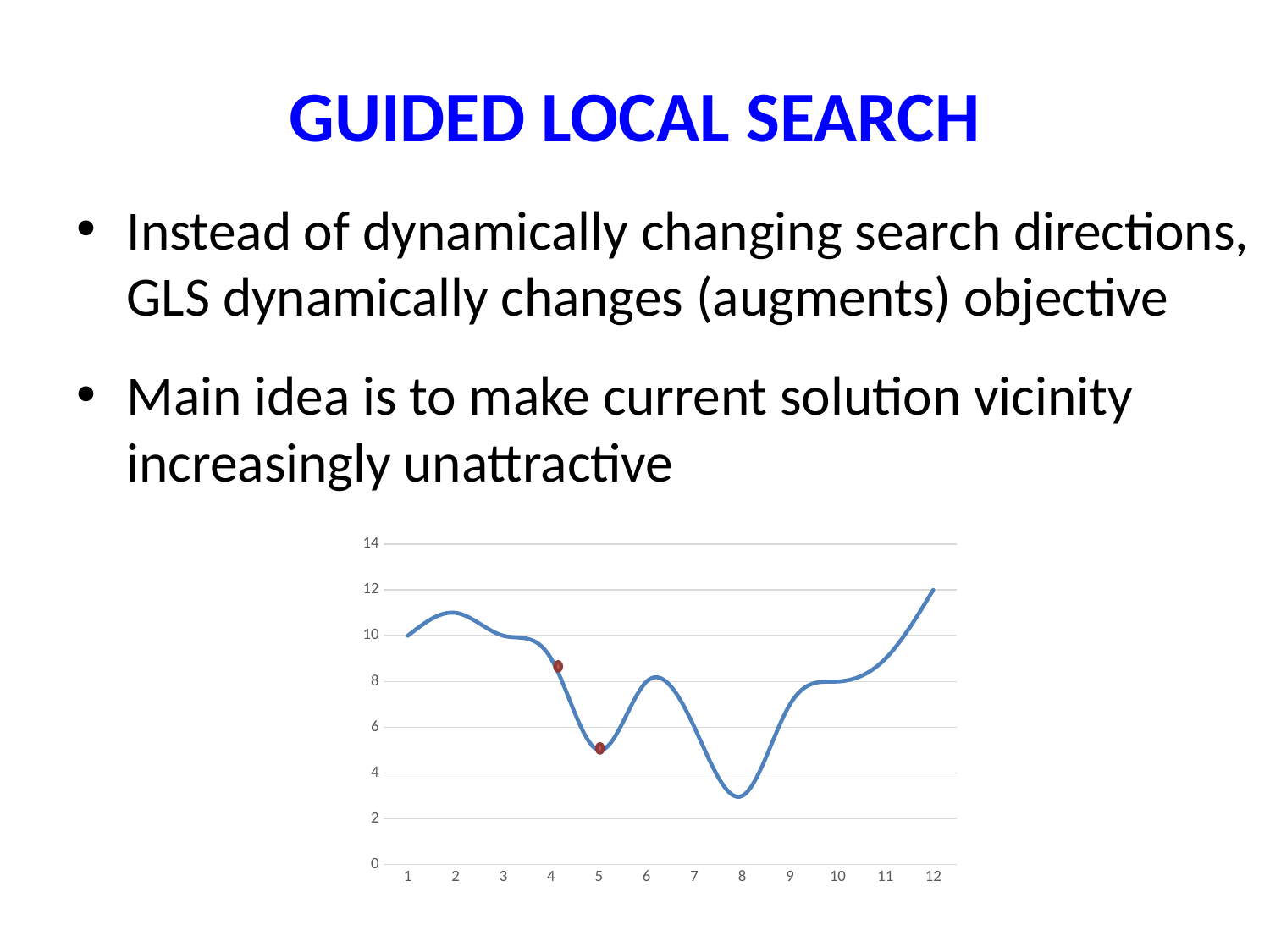
Does the line rise or fall between x = 8 and x = 12? rise How many points are plotted along the x axis of the chart? 12 What kind of chart is shown on the slide? line chart Which has the larger value on the line, x = 2 or x = 8? x = 2 Which has the larger value on the line, x = 5 or x = 6? x = 6 At which x-axis value does the line reach its highest point? 12 Is the value of the line at x = 5 greater or less than 6? less Is the value of the line at x = 8 greater or less than 4? less Is the value of the line at x = 9 greater or less than 6? greater At which x-axis value does the line reach its lowest point? 8 How many red marker dots are drawn on the line? 2